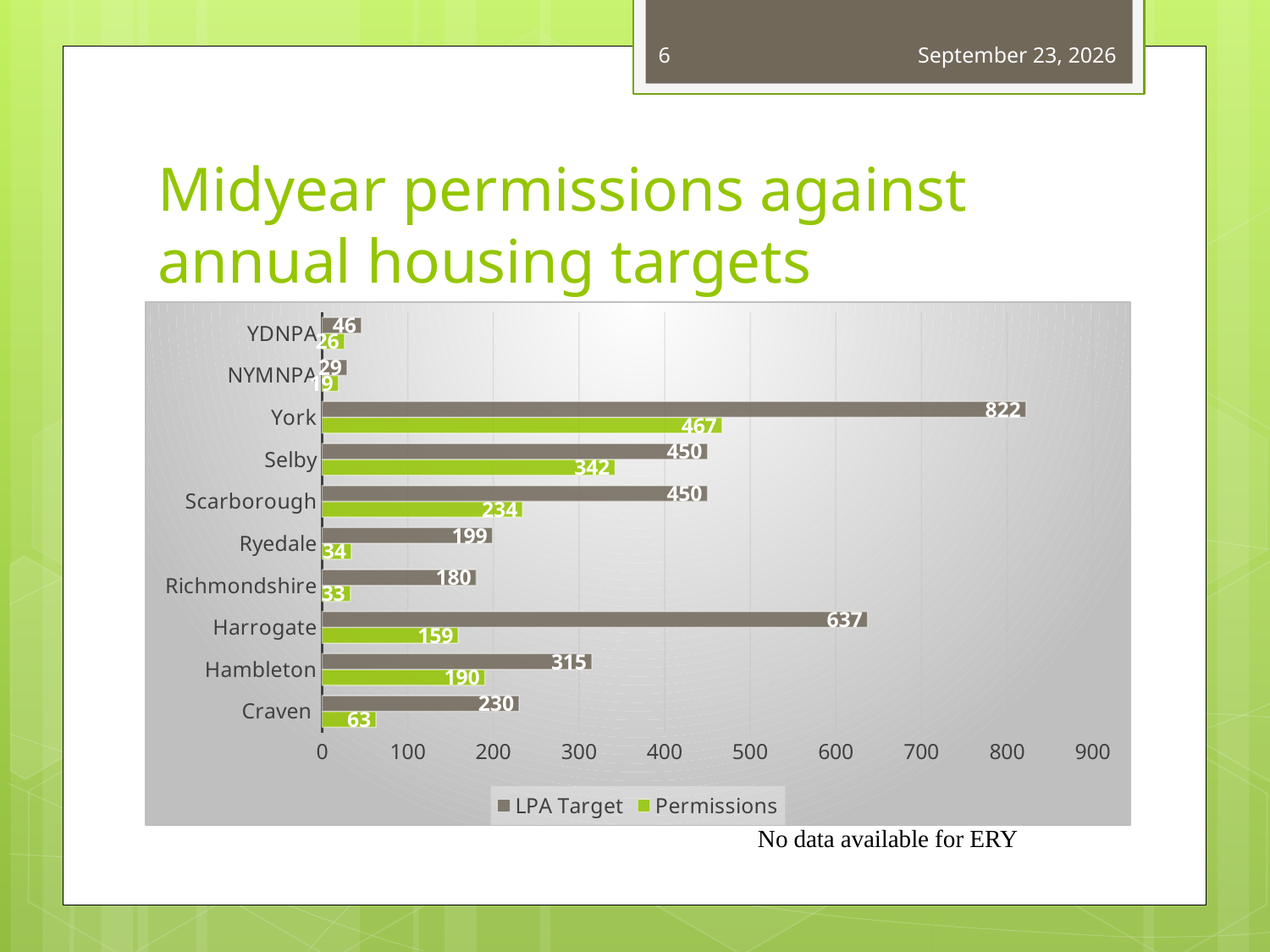
What is the LPA Target value for York? 822 How many categories are shown on the chart? 10 What kind of chart is shown on the slide? Bar chart Is the LPA Target for Scarborough greater or less than 400? greater Which category has the lowest Permissions value? NYMNPA How many series does the legend list? 2 What is the difference between the LPA Target and Permissions for Harrogate? 478 Which category has the highest LPA Target? York What is the Permissions value for Craven? 63 Which is larger, the Permissions value for Hambleton or the Permissions value for Harrogate? Hambleton What is the Permissions value for Selby? 342 What are the two series named in the legend? LPA Target and Permissions